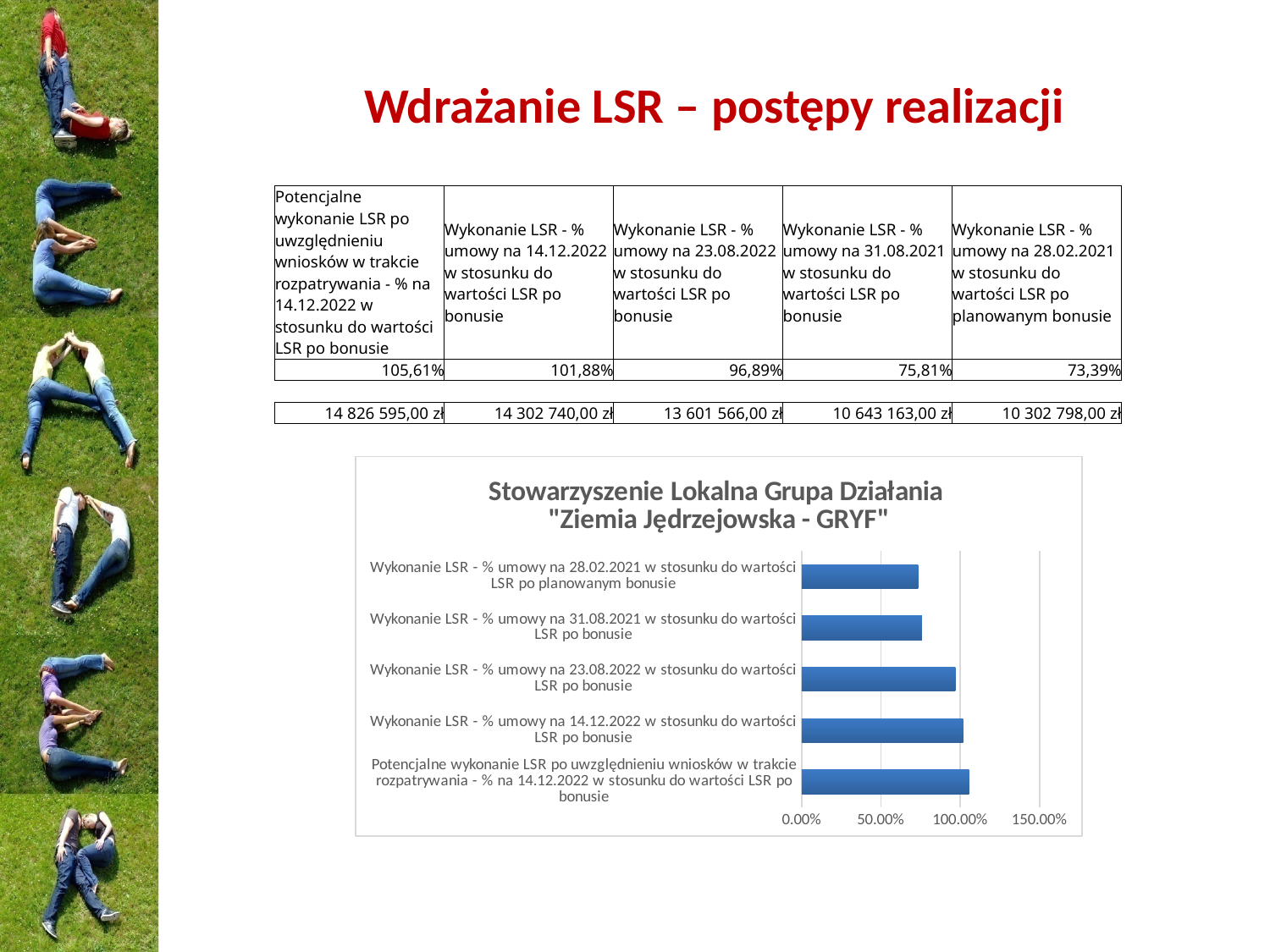
Is the value for "Wykonanie LSR - % umowy na 14.12.2022 w stosunku do wartości LSR po bonusie" greater or less than 100.00%? greater What is the title of the chart? Stowarzyszenie Lokalna Grupa Działania "Ziemia Jędrzejowska - GRYF" Which is larger: the value for "Wykonanie LSR - % umowy na 23.08.2022" or for "Wykonanie LSR - % umowy na 31.08.2021"? Wykonanie LSR - % umowy na 23.08.2022 What is the highest value shown on the chart's horizontal axis? 150.00% How many bars does the chart contain? 5 Is the value for "Wykonanie LSR - % umowy na 28.02.2021 w stosunku do wartości LSR po planowanym bonusie" greater or less than 50.00%? greater Is the value for "Wykonanie LSR - % umowy na 31.08.2021 w stosunku do wartości LSR po bonusie" greater or less than 100.00%? less Which is larger: the value for "Wykonanie LSR - % umowy na 14.12.2022" or for "Wykonanie LSR - % umowy na 28.02.2021"? Wykonanie LSR - % umowy na 14.12.2022 Which category has the longest bar in the chart? Potencjalne wykonanie LSR po uwzględnieniu wniosków w trakcie rozpatrywania - % na 14.12.2022 w stosunku do wartości LSR po bonusie What kind of chart is shown on the slide? bar chart